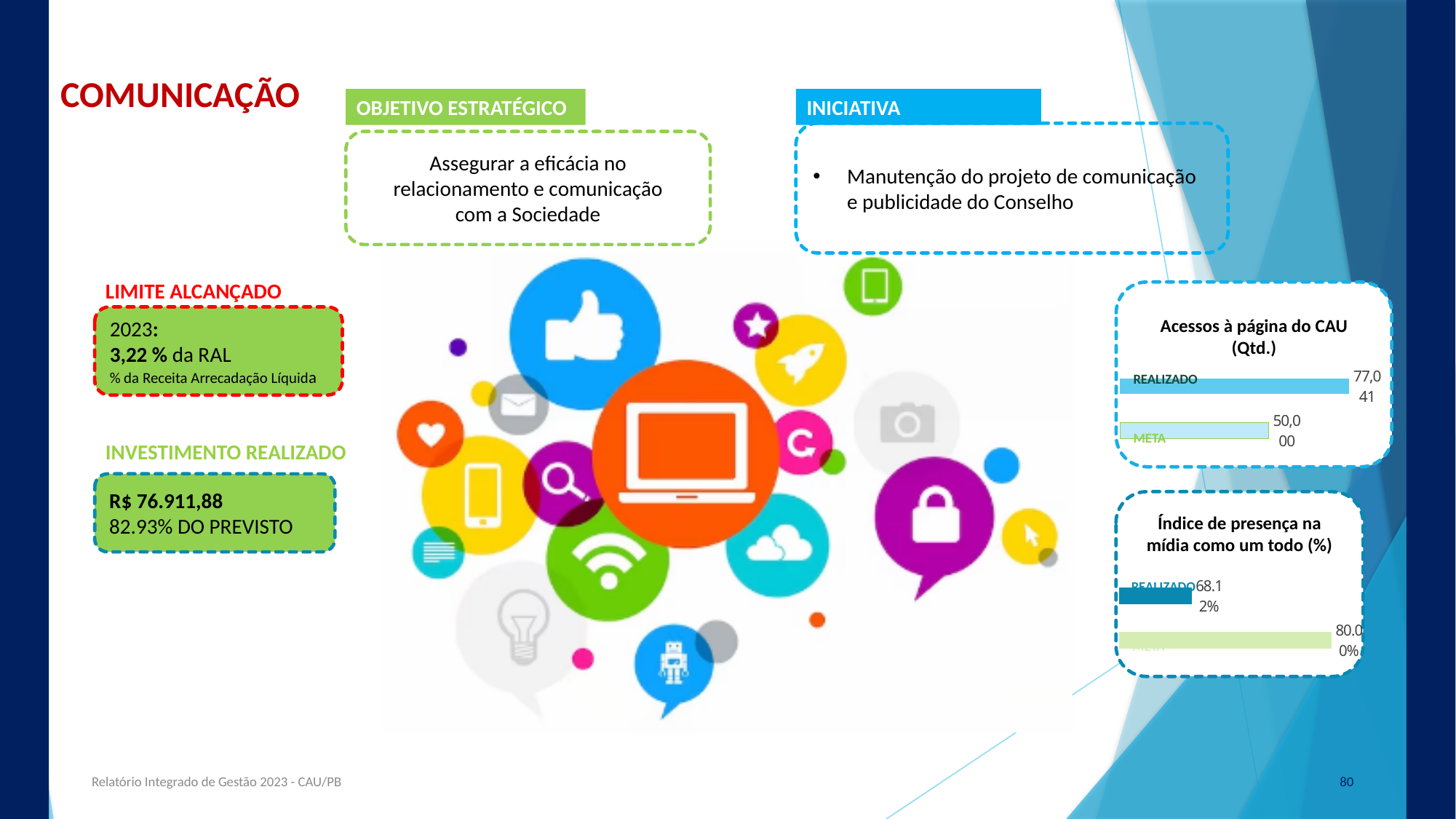
In the chart titled "Acessos à página do CAU (Qtd.)", what is the difference between REALIZADO and META? 27,041 What kind of chart is "Acessos à página do CAU (Qtd.)"? Bar chart In the chart titled "Índice de presença na mídia como um todo (%)", what is the difference between META and REALIZADO? 11.88% In the chart titled "Acessos à página do CAU (Qtd.)", what is the value for META? 50,000 What kind of chart is "Índice de presença na mídia como um todo (%)"? Bar chart In the chart titled "Acessos à página do CAU (Qtd.)", what is the value for REALIZADO? 77,041 In the chart titled "Índice de presença na mídia como um todo (%)", what is the value for REALIZADO? 68.12% In the chart titled "Acessos à página do CAU (Qtd.)", how many bars are plotted? 2 In the chart titled "Índice de presença na mídia como um todo (%)", what is the value for META? 80.00% In the chart titled "Índice de presença na mídia como um todo (%)", which category has the lowest value? REALIZADO In the chart titled "Acessos à página do CAU (Qtd.)", which bar is longer, REALIZADO or META? REALIZADO In the chart titled "Índice de presença na mídia como um todo (%)", which bar is longer, REALIZADO or META? META